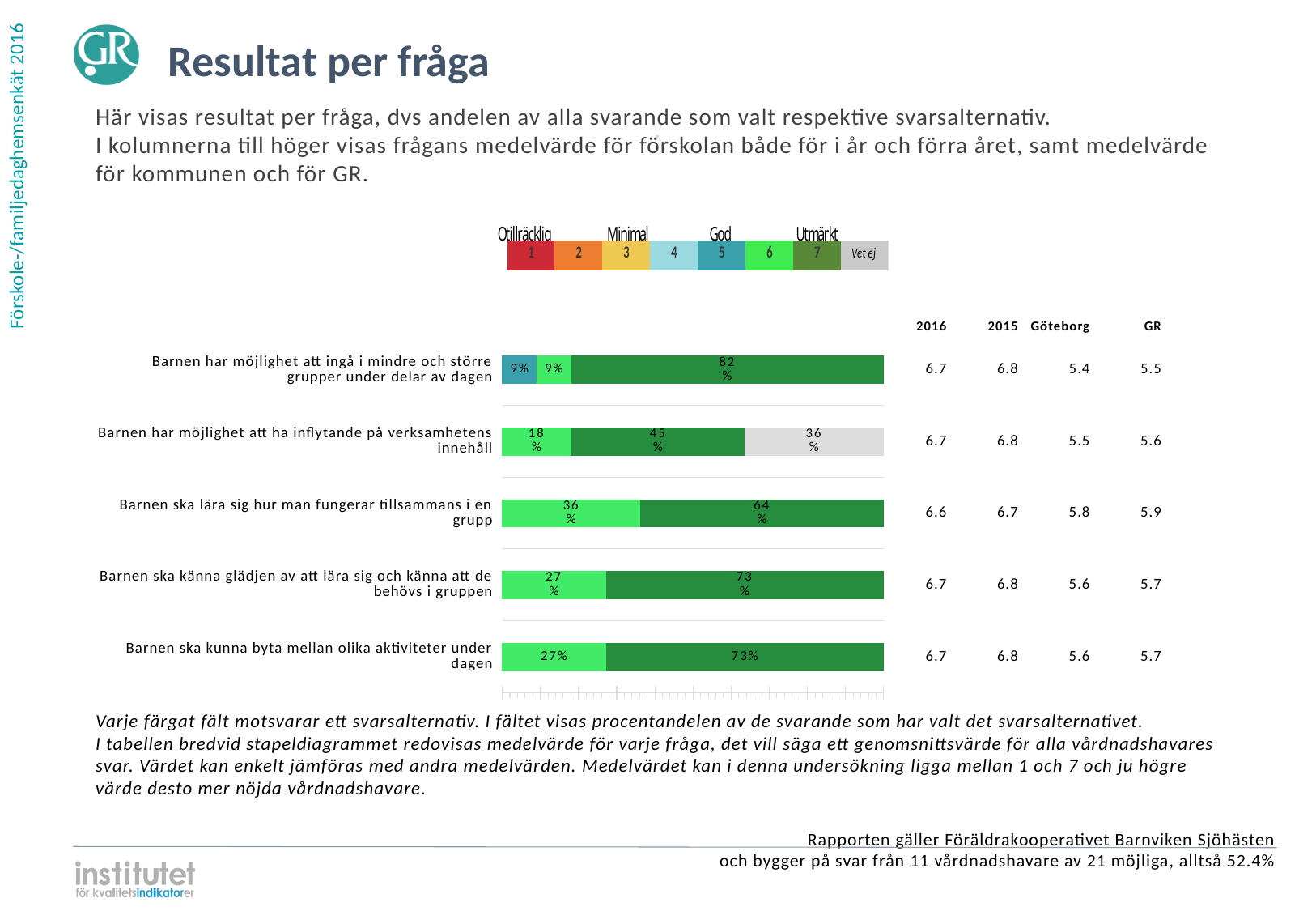
For 'Barnen ska lära sig hur man fungerar tillsammans i en grupp', how many percentage points larger is the share for answer 7 than for answer 6? 28 What is the 2016 mean value shown for 'Barnen ska lära sig hur man fungerar tillsammans i en grupp'? 6.6 What kind of chart is used to show the results per question on this slide? Stacked bar chart How many questions (categories) are shown as bars in the chart? 5 Which question has the smallest share of answer 7 (dark green)? Barnen har möjlighet att ha inflytande på verksamhetens innehåll What colour represents the 'Vet ej' answer alternative in the legend? Grey For 'Barnen ska känna glädjen av att lära sig och känna att de behövs i gruppen', which is larger: the share for answer 6 or for answer 7? Answer 7 How many answer alternatives does the legend above the chart list? 8 What percentage chose 'Vet ej' for 'Barnen har möjlighet att ha inflytande på verksamhetens innehåll'? 36% Which question has the largest share of answer 7 (dark green)? Barnen har möjlighet att ingå i mindre och större grupper under delar av dagen What percentage of respondents chose answer 7 (dark green) for 'Barnen har möjlighet att ingå i mindre och större grupper under delar av dagen'? 82% What is the total of the three segments in the bar for 'Barnen har möjlighet att ingå i mindre och större grupper under delar av dagen'? 100%